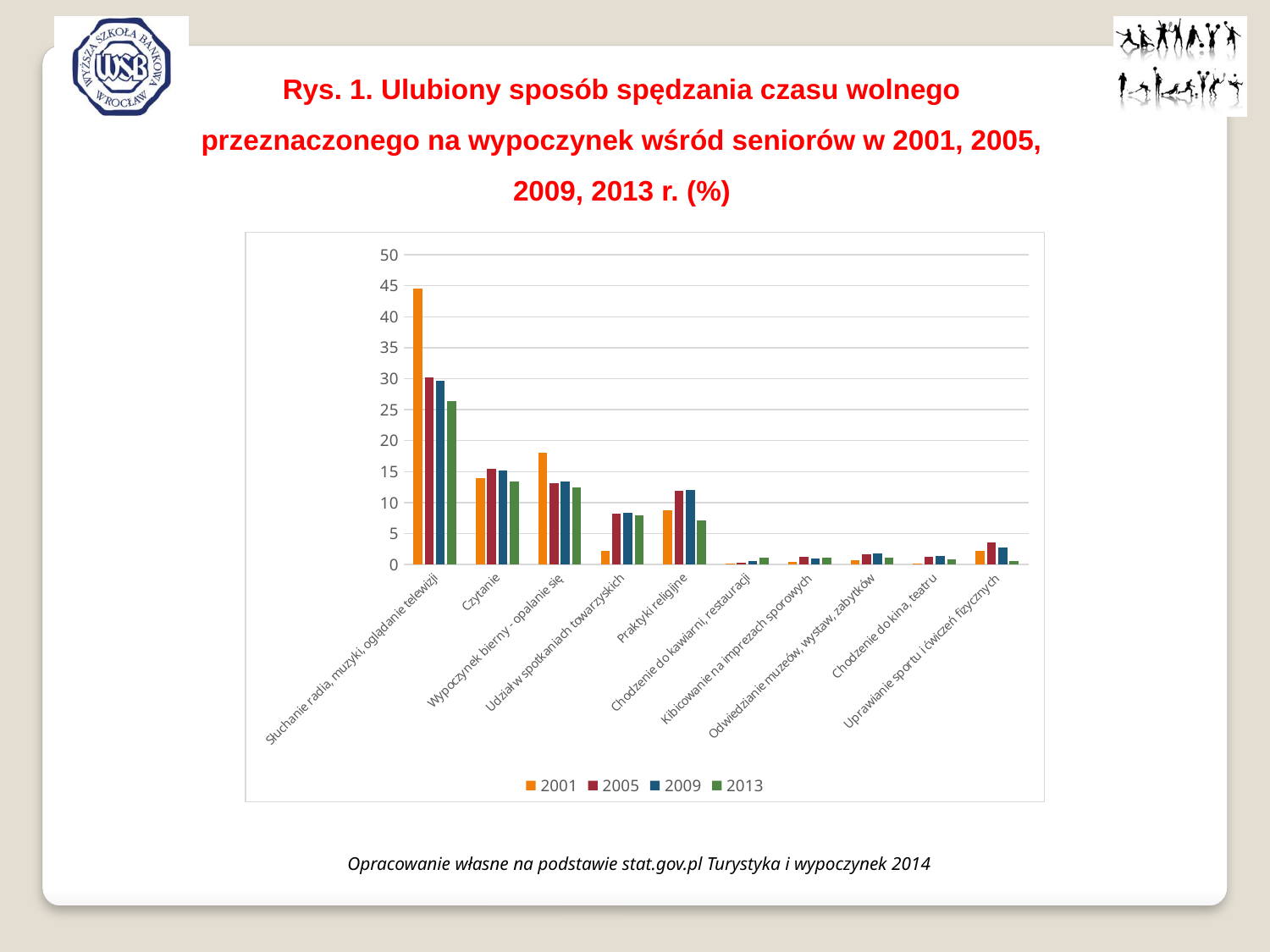
Do the values for 'Słuchanie radia, muzyki, oglądanie telewizji' rise or fall from 2001 to 2013? fall Which category has the highest value for 2001? Słuchanie radia, muzyki, oglądanie telewizji Is the 2005 value for 'Praktyki religijne' greater or less than 10? greater For 'Udział w spotkaniach towarzyskich', which year has the larger value, 2001 or 2005? 2005 Is the 2001 value for 'Wypoczynek bierny - opalanie się' greater or less than 15? greater Is the 2013 value for 'Słuchanie radia, muzyki, oglądanie telewizji' greater or less than 30? less What kind of chart is shown on the slide? bar chart How many series does the legend list? 4 What colour represents the 2001 series in the legend? orange For 'Wypoczynek bierny - opalanie się', which year has the larger value, 2001 or 2013? 2001 How many categories are shown on the x axis? 10